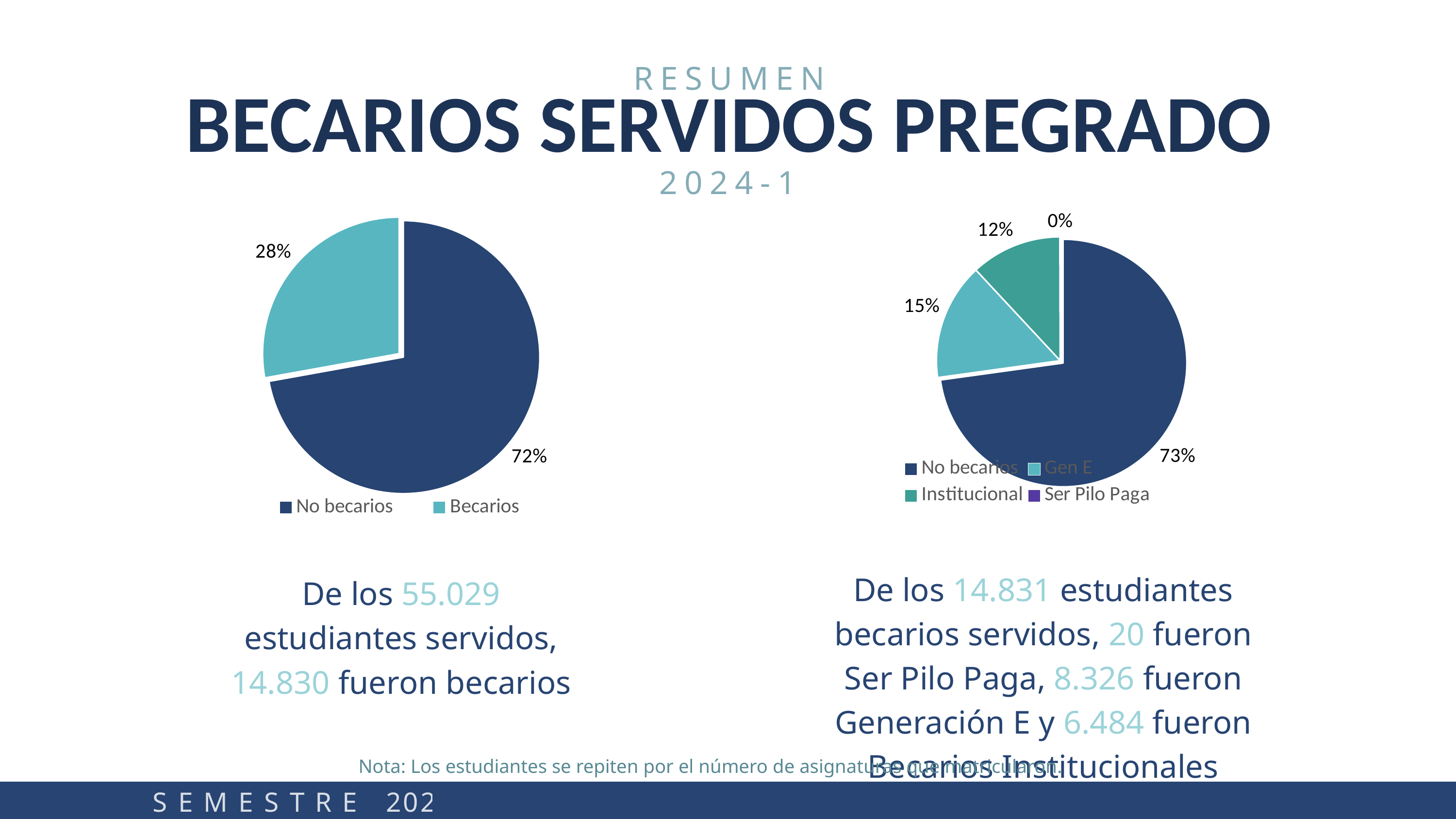
In the right pie chart, which category has the smallest share? Ser Pilo Paga In the left pie chart, what percentage is shown for No becarios? 72% In the right pie chart, what percentage is shown for No becarios? 73% How many categories does the legend of the right pie chart list? 4 How many entries does the legend of the left pie chart list? 2 In the right pie chart, what percentage is shown for Gen E? 15% What kind of chart is the left chart? Pie chart In the right pie chart, which is larger, Gen E or Institucional? Gen E In the right pie chart, what percentage is shown for Institucional? 12% In the left pie chart, what percentage is shown for Becarios? 28% In the left pie chart, which slice is the largest? No becarios In the left pie chart, what is the difference in percentage points between No becarios and Becarios? 44